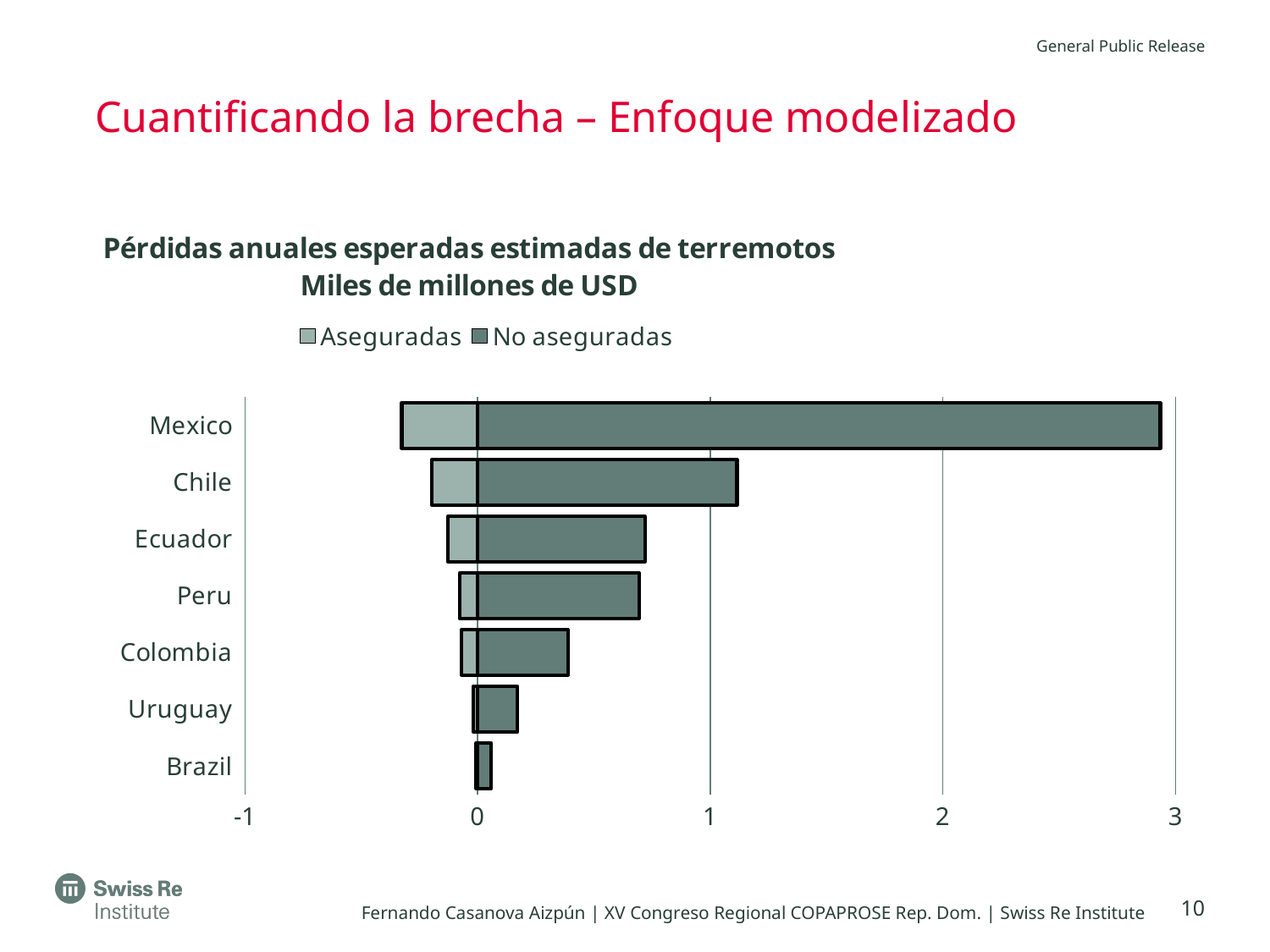
What kind of chart is shown on the slide? bar chart Which has a larger 'No aseguradas' value, Colombia or Uruguay? Colombia Is the 'No aseguradas' value for Mexico greater or less than 2? greater Which has a larger 'No aseguradas' value, Chile or Ecuador? Chile Do the 'No aseguradas' values increase or decrease going down the chart from Mexico to Brazil? decrease Is the 'No aseguradas' value for Ecuador greater or less than 1? less Which country has the lowest 'No aseguradas' value? Brazil What are the two series named in the legend? Aseguradas and No aseguradas How many countries are shown on the chart? 7 How many series does the legend list? 2 Which country has the highest 'No aseguradas' value? Mexico Is the 'No aseguradas' value for Chile greater or less than 1? greater